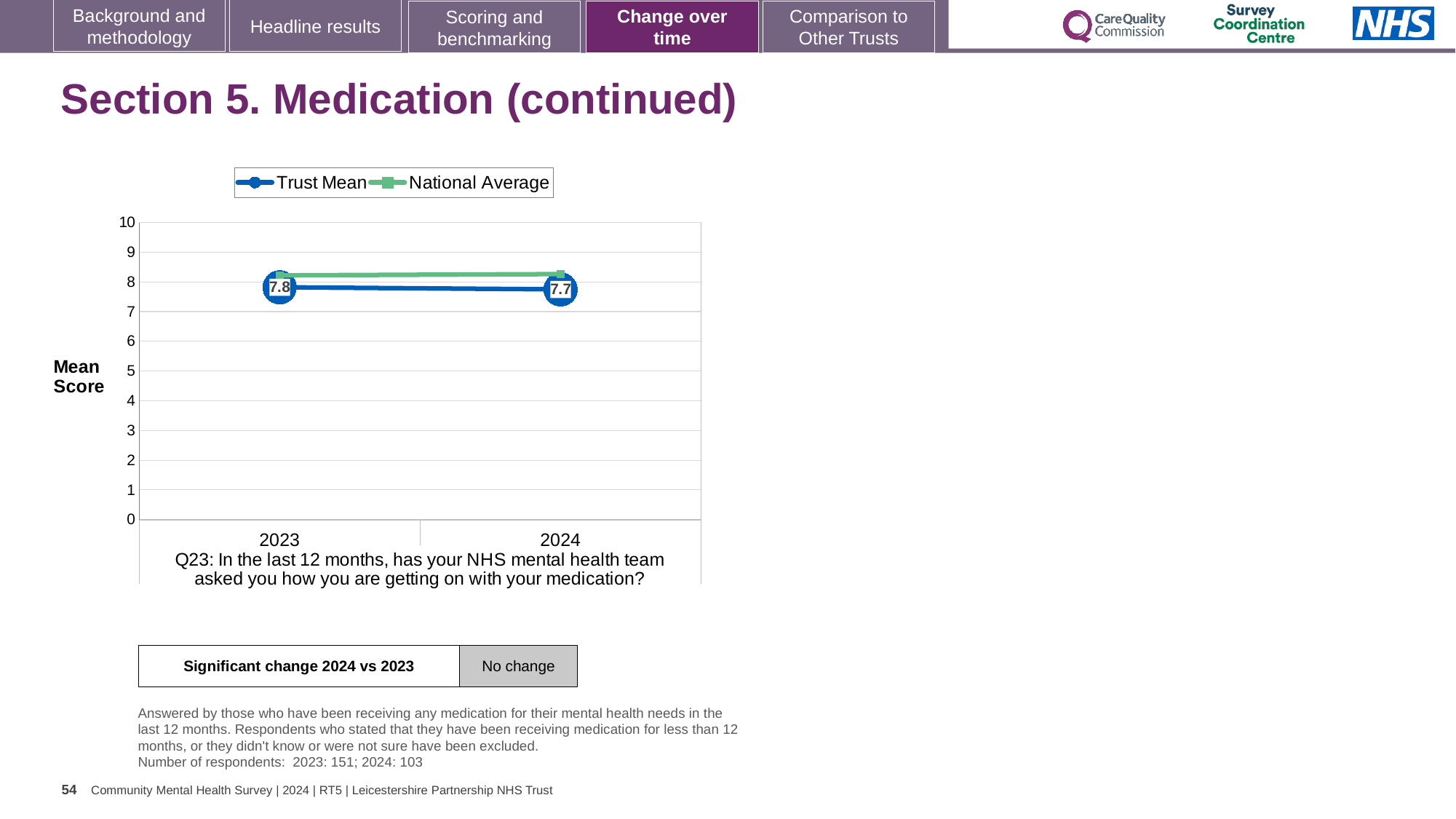
Which year has the higher Trust Mean score, 2023 or 2024? 2023 How many years are plotted on the x axis? 2 Is the National Average for 2023 greater or less than 7? greater What is the label on the y axis of the chart? Mean Score Does the Trust Mean rise or fall from 2023 to 2024? Fall What kind of chart is shown on the slide? Line chart By how much did the Trust Mean change between 2023 and 2024? 0.1 What is the Trust Mean score for 2024? 7.7 Is the National Average for 2024 greater or less than 9? less What is the Trust Mean score for 2023? 7.8 In 2024, which is higher: the Trust Mean or the National Average? National Average How many series does the legend list? 2